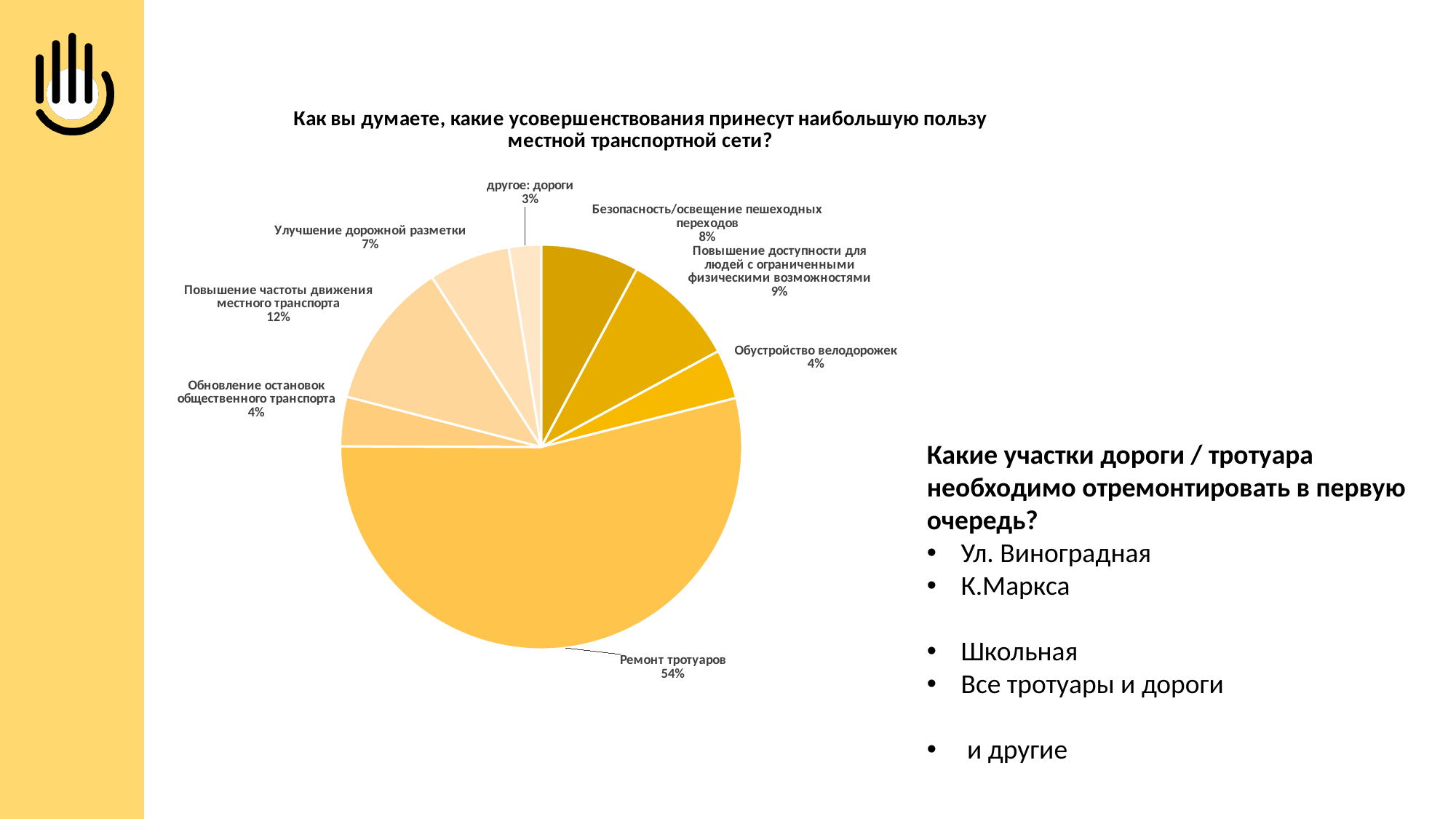
Which category has the largest share of the pie? Ремонт тротуаров How many categories (slices) does the pie chart have? 8 What type of chart is shown on the slide? Pie chart What is the title of the pie chart? Как вы думаете, какие усовершенствования принесут наибольшую пользу местной транспортной сети? What is the value shown for "Безопасность/освещение пешеходных переходов"? 8% Which category has the smallest share of the pie? другое: дороги What is the value shown for "Повышение частоты движения местного транспорта"? 12% What share of the pie does "Ремонт тротуаров" represent? 54% What is the value shown for "Повышение доступности для людей с ограниченными физическими возможностями"? 9% Which is larger: the share for "Безопасность/освещение пешеходных переходов" or for "Обустройство велодорожек"? Безопасность/освещение пешеходных переходов What is the difference between the shares of "Ремонт тротуаров" and "Повышение частоты движения местного транспорта"? 42% What is the value shown for "Улучшение дорожной разметки"? 7%